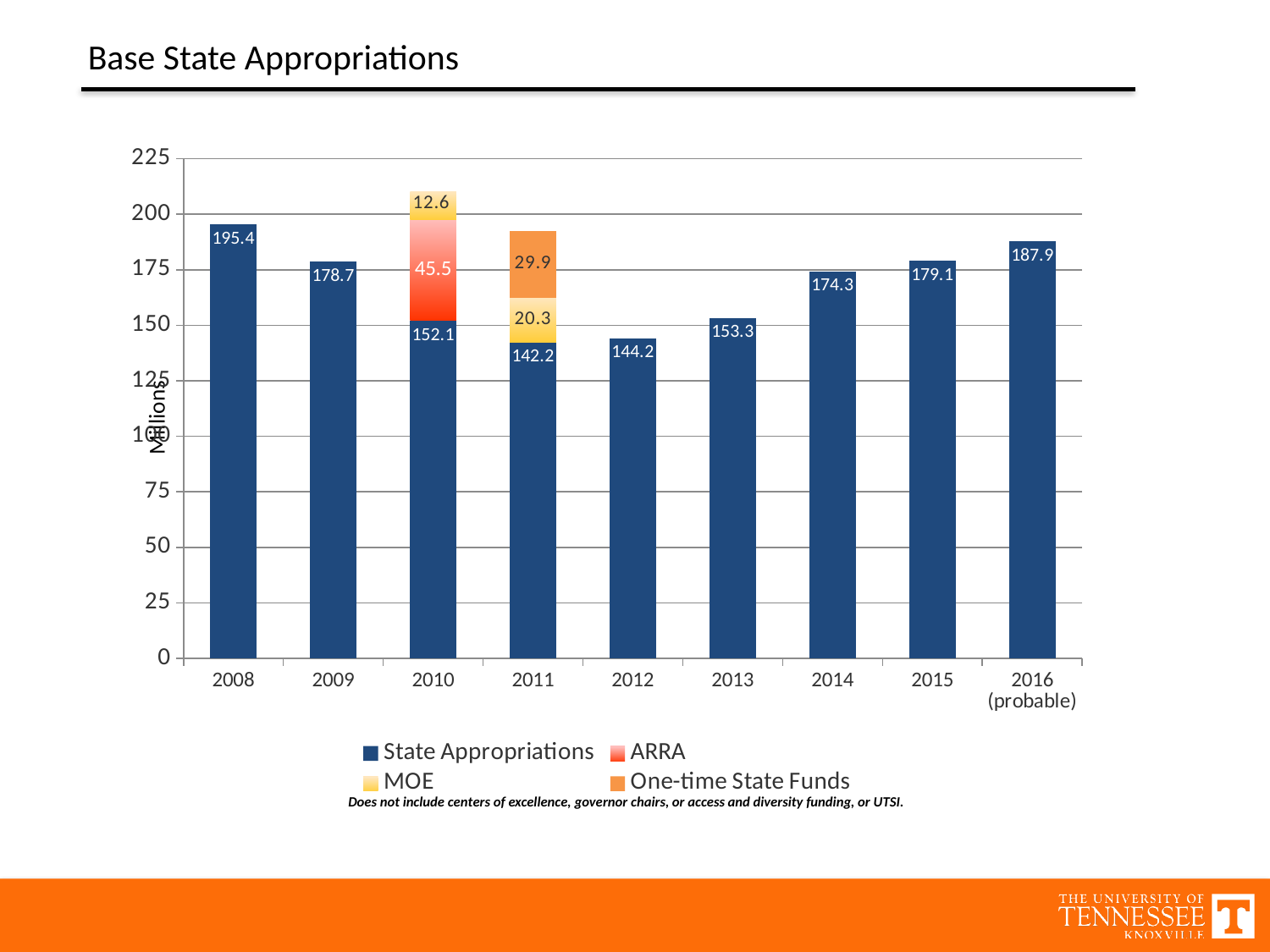
How many series does the legend list? 4 What is the One-time State Funds value for 2011? 29.9 What kind of chart is shown on the slide? Stacked bar chart Which year has the lowest State Appropriations value? 2011 Which is larger, the State Appropriations value for 2014 or for 2015? 2015 How many years are shown on the x axis? 9 What is the difference between the State Appropriations values for 2008 and 2009? 16.7 What is the total of the stacked bar for 2011? 192.4 What is the State Appropriations value for 2008? 195.4 Which year has the highest State Appropriations value? 2008 What is the total of the stacked bar for 2010? 210.2 What is the ARRA value for 2010? 45.5